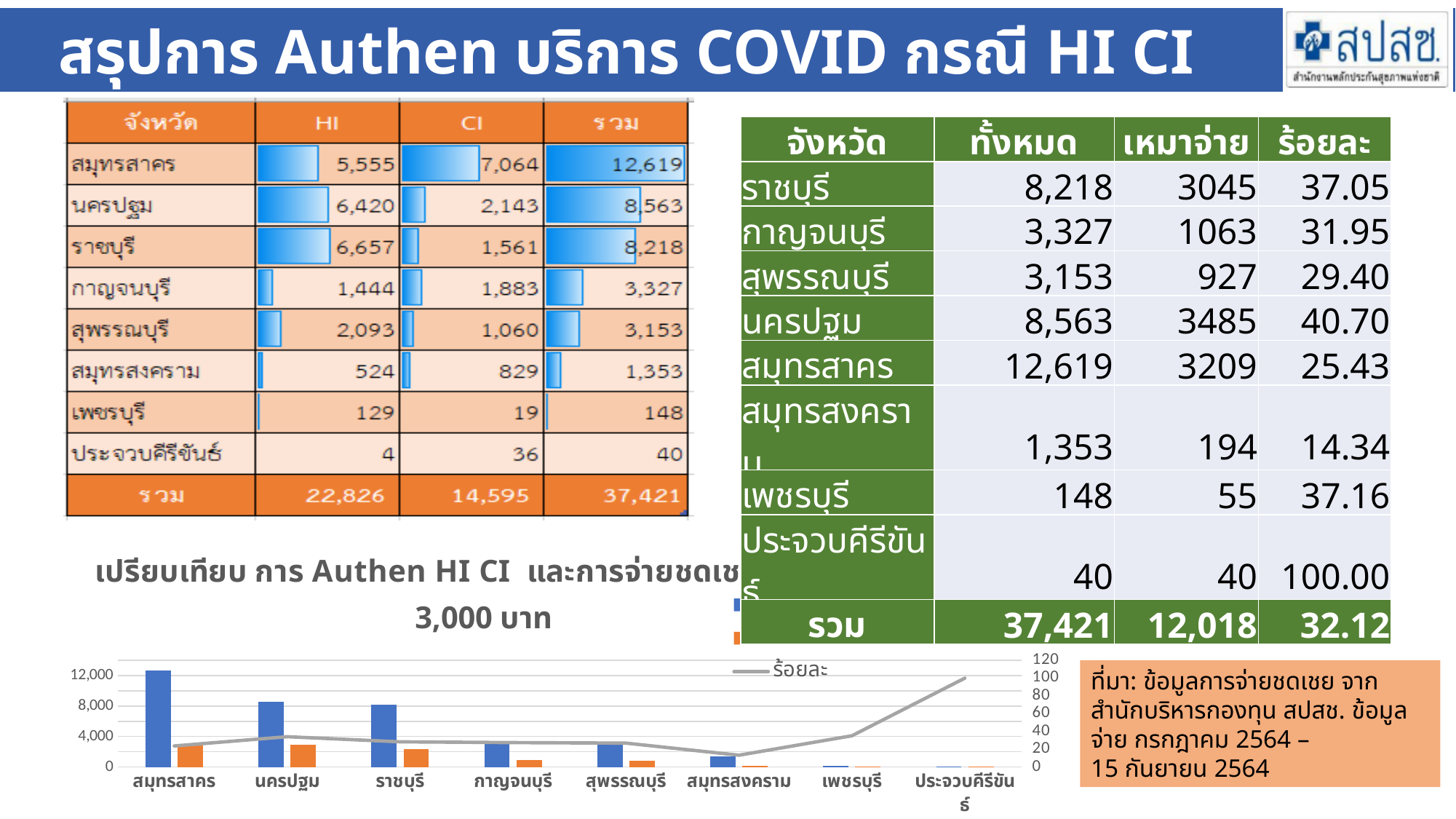
In the bottom chart, which has the taller orange bar, สมุทรสาคร or กาญจนบุรี? สมุทรสาคร How many provinces are shown on the x axis of the bottom chart? 8 In the bottom chart, is the blue bar for ราชบุรี greater or less than 4,000? greater In the bottom chart, which province has the highest point on the ร้อยละ line? ประจวบคีรีขันธ์ In the bottom chart, is the blue bar for กาญจนบุรี greater or less than 4,000? less In the bottom chart, which province has the lowest point on the ร้อยละ line? สมุทรสงคราม In the bottom chart, is the blue bar for สมุทรสาคร greater or less than 8,000? greater What kind of chart is shown at the bottom of the slide? bar chart with a line In the bottom chart, which has the taller blue bar, สมุทรสาคร or นครปฐม? สมุทรสาคร What is the highest tick value shown on the right-hand axis of the bottom chart? 120 In the bottom chart, does the ร้อยละ line rise or fall from สมุทรสงคราม to ประจวบคีรีขันธ์? rise In the bottom chart, which province has the tallest blue bar? สมุทรสาคร